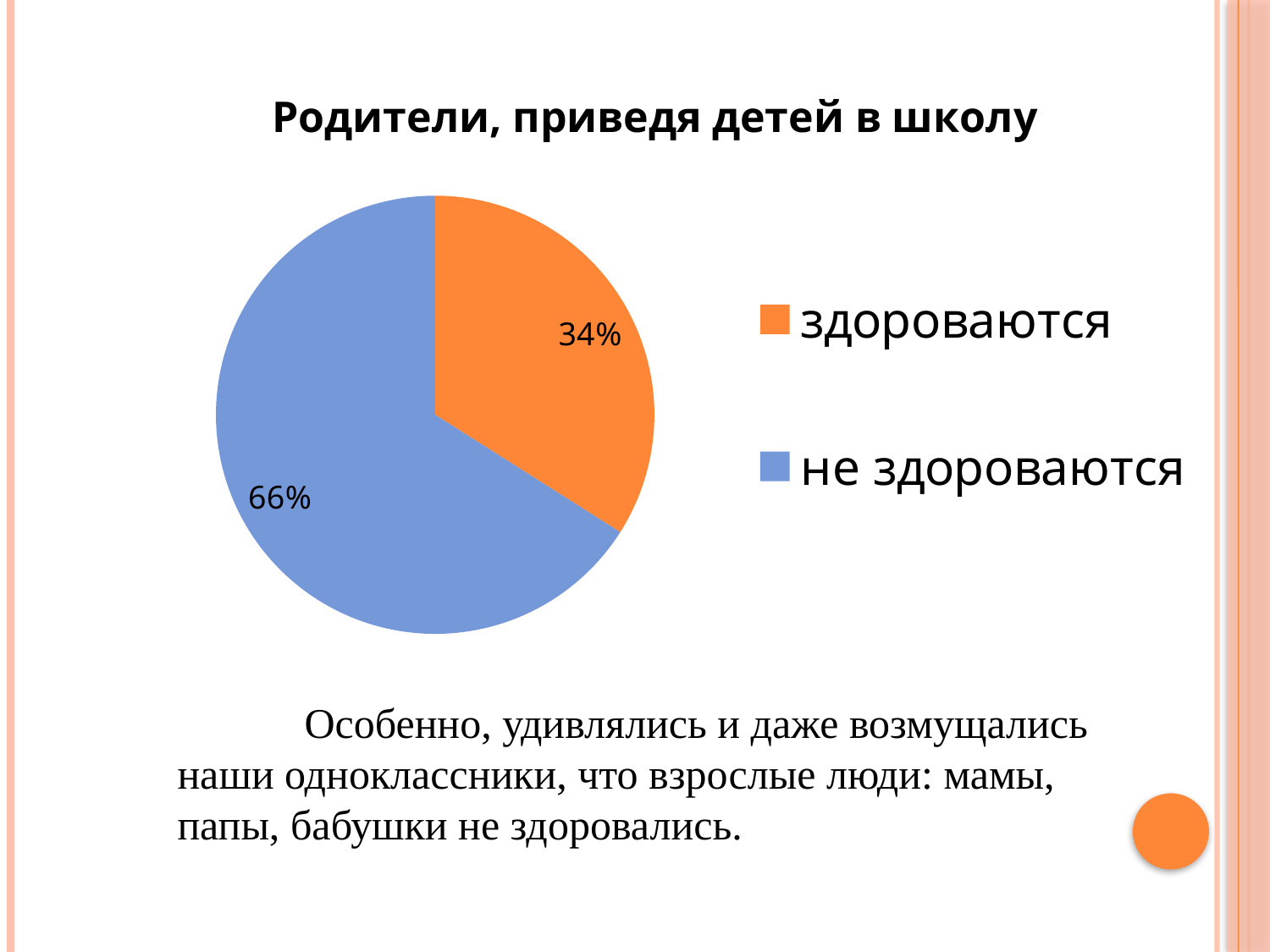
Which slice of the pie is the largest? не здороваются What is the difference in percentage points between "не здороваются" and "здороваются"? 32 What percentage of the pie is labelled "здороваются"? 34% What kind of chart is shown on the slide? pie chart What share of the pie does the "не здороваются" slice take? 66% Which is larger: the share for "здороваются" or the share for "не здороваются"? не здороваются How many slices does the pie chart have? 2 Which slice of the pie is the smallest? здороваются What percentage of the pie is labelled "не здороваются"? 66% What is the title of the chart? Родители, приведя детей в школу How many entries does the legend list? 2 What colour is the slice for "здороваются"? orange